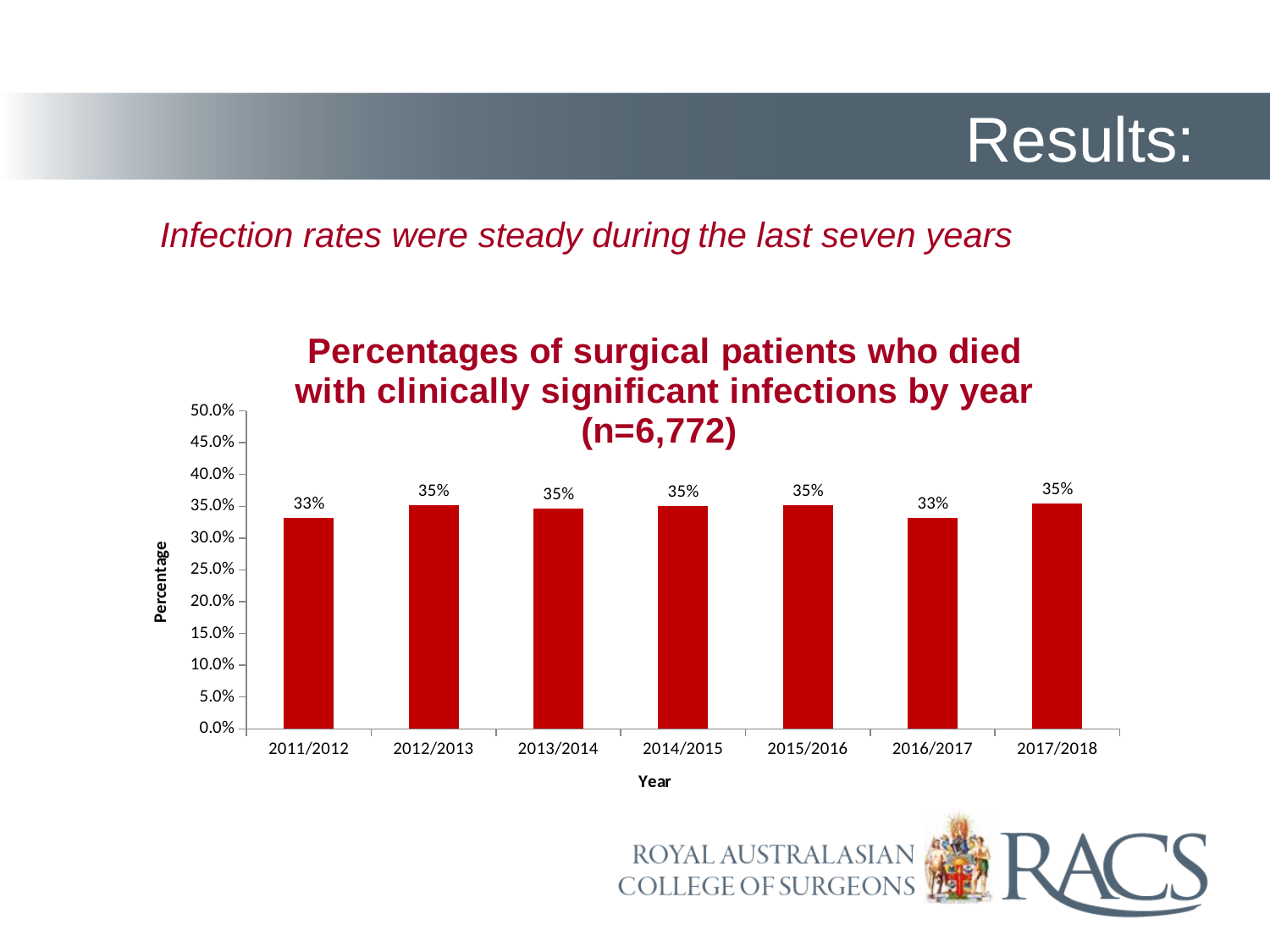
What is the value for 2016/2017? 33% Is the value for 2016/2017 greater or less than 30.0%? greater What is the value for 2017/2018? 35% Is the value for 2013/2014 greater or less than 40.0%? less What is the label of the y axis? Percentage What is the difference between the value for 2012/2013 and the value for 2011/2012? 2% What is the value for 2014/2015? 35% How many years are shown on the x axis? 7 What kind of chart is shown on the slide? Bar chart Which is larger, the value for 2015/2016 or the value for 2016/2017? 2015/2016 What is the value for 2011/2012? 33% Which is larger, the value for 2011/2012 or the value for 2012/2013? 2012/2013